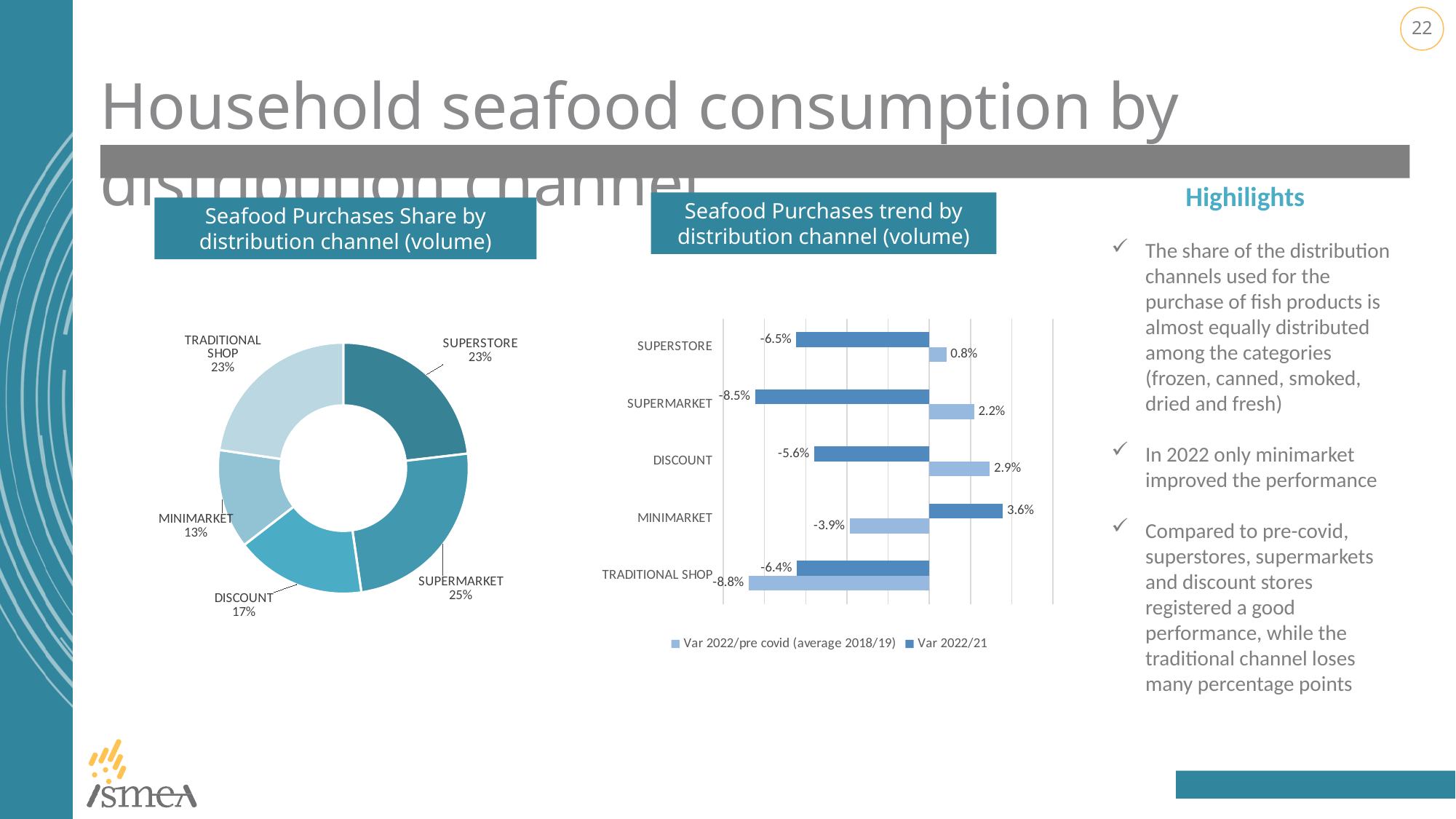
In the 'Seafood Purchases trend by distribution channel (volume)' chart, which channel has the lowest Var 2022/21 value? SUPERMARKET In the 'Seafood Purchases Share by distribution channel (volume)' chart, which channel has the smallest share? MINIMARKET How many series does the legend of the 'Seafood Purchases trend by distribution channel (volume)' chart list? 2 What kind of chart is the 'Seafood Purchases trend by distribution channel (volume)' chart? Bar chart In the 'Seafood Purchases trend by distribution channel (volume)' chart, which is larger for Var 2022/pre covid (average 2018/19): DISCOUNT or SUPERMARKET? DISCOUNT How many distribution channels are shown in the 'Seafood Purchases Share by distribution channel (volume)' chart? 5 In the 'Seafood Purchases Share by distribution channel (volume)' chart, what is the difference in share between SUPERMARKET and DISCOUNT? 8 percentage points In the 'Seafood Purchases Share by distribution channel (volume)' chart, which channel has the largest share? SUPERMARKET In the 'Seafood Purchases trend by distribution channel (volume)' chart, what is the Var 2022/pre covid (average 2018/19) value for TRADITIONAL SHOP? -8.8% What kind of chart is the 'Seafood Purchases Share by distribution channel (volume)' chart? Pie (doughnut) chart In the 'Seafood Purchases Share by distribution channel (volume)' chart, what share does SUPERMARKET have? 25% In the 'Seafood Purchases trend by distribution channel (volume)' chart, what is the Var 2022/21 value for MINIMARKET? 3.6%